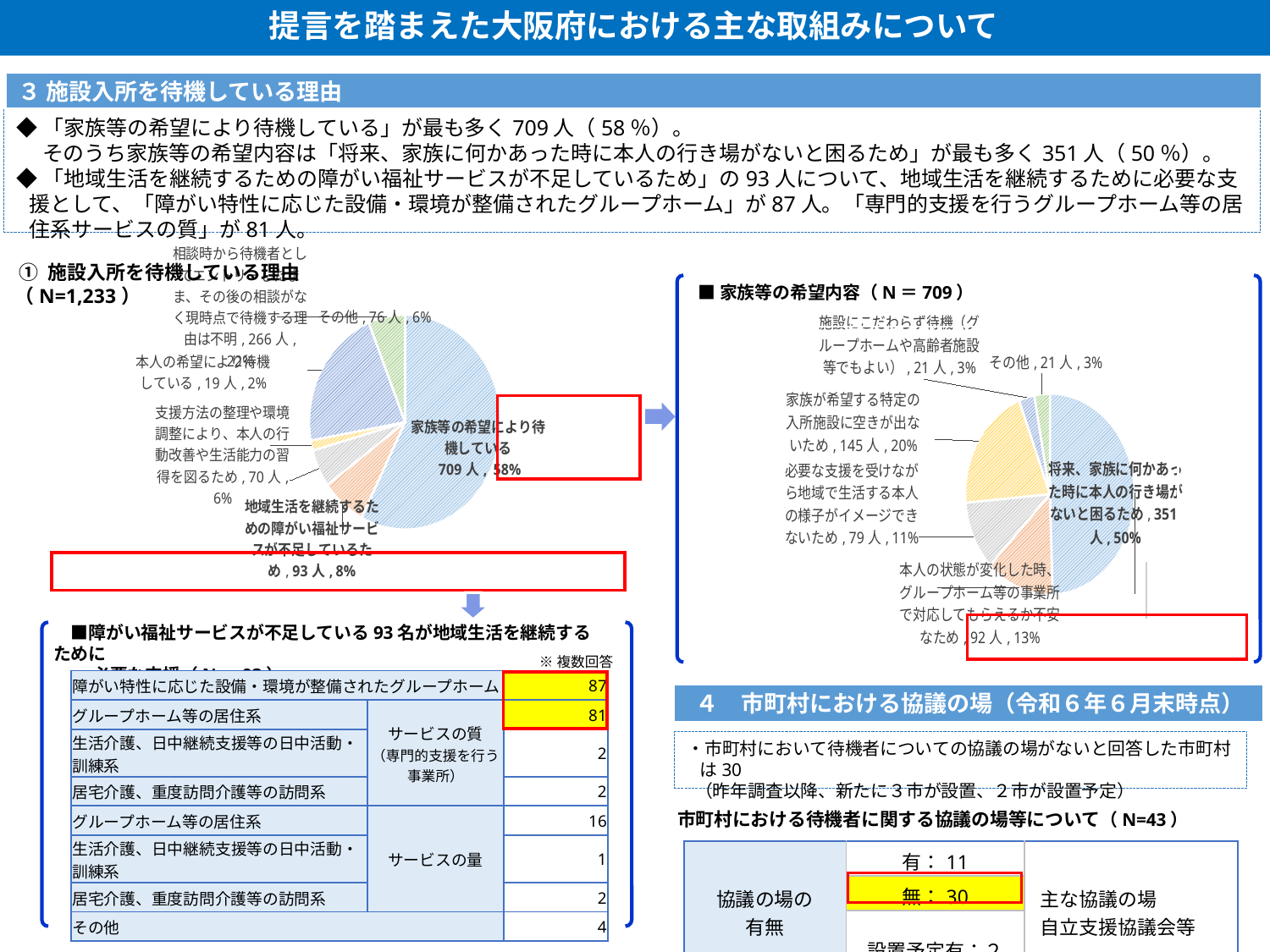
In the pie chart '① 施設入所を待機している理由 (N=1,233)', which category has the smallest share? 本人の希望により待機している In the pie chart '■ 家族等の希望内容 (N = 709)', which is larger: '本人の状態が変化した時、グループホーム等の事業所で対応してもらえるか不安なため' or '必要な支援を受けながら地域で生活する本人の様子がイメージできないため'? 本人の状態が変化した時、グループホーム等の事業所で対応してもらえるか不安なため In the pie chart '① 施設入所を待機している理由 (N=1,233)', what percentage is shown for 'その他'? 6% In the pie chart '① 施設入所を待機している理由 (N=1,233)', which category has the largest share? 家族等の希望により待機している In the pie chart '■ 家族等の希望内容 (N = 709)', how many people are in the '家族が希望する特定の入所施設に空きが出ないため' slice? 145 人 What type of chart is used for '■ 家族等の希望内容 (N = 709)'? Pie chart In the pie chart '① 施設入所を待機している理由 (N=1,233)', what is the difference in people between '家族等の希望により待機している' and '地域生活を継続するための障がい福祉サービスが不足しているため'? 616 人 In the pie chart '■ 家族等の希望内容 (N = 709)', what percentage is shown for '将来、家族に何かあった時に本人の行き場がないと困るため'? 50% In the pie chart '① 施設入所を待機している理由 (N=1,233)', how many people are in the '家族等の希望により待機している' slice? 709 人 In the pie chart '■ 家族等の希望内容 (N = 709)', what is the difference in people between '家族が希望する特定の入所施設に空きが出ないため' and '本人の状態が変化した時、グループホーム等の事業所で対応してもらえるか不安なため'? 53 人 In the pie chart '■ 家族等の希望内容 (N = 709)', how many slices does the pie have? 6 In the pie chart '① 施設入所を待機している理由 (N=1,233)', how many slices does the pie have? 6